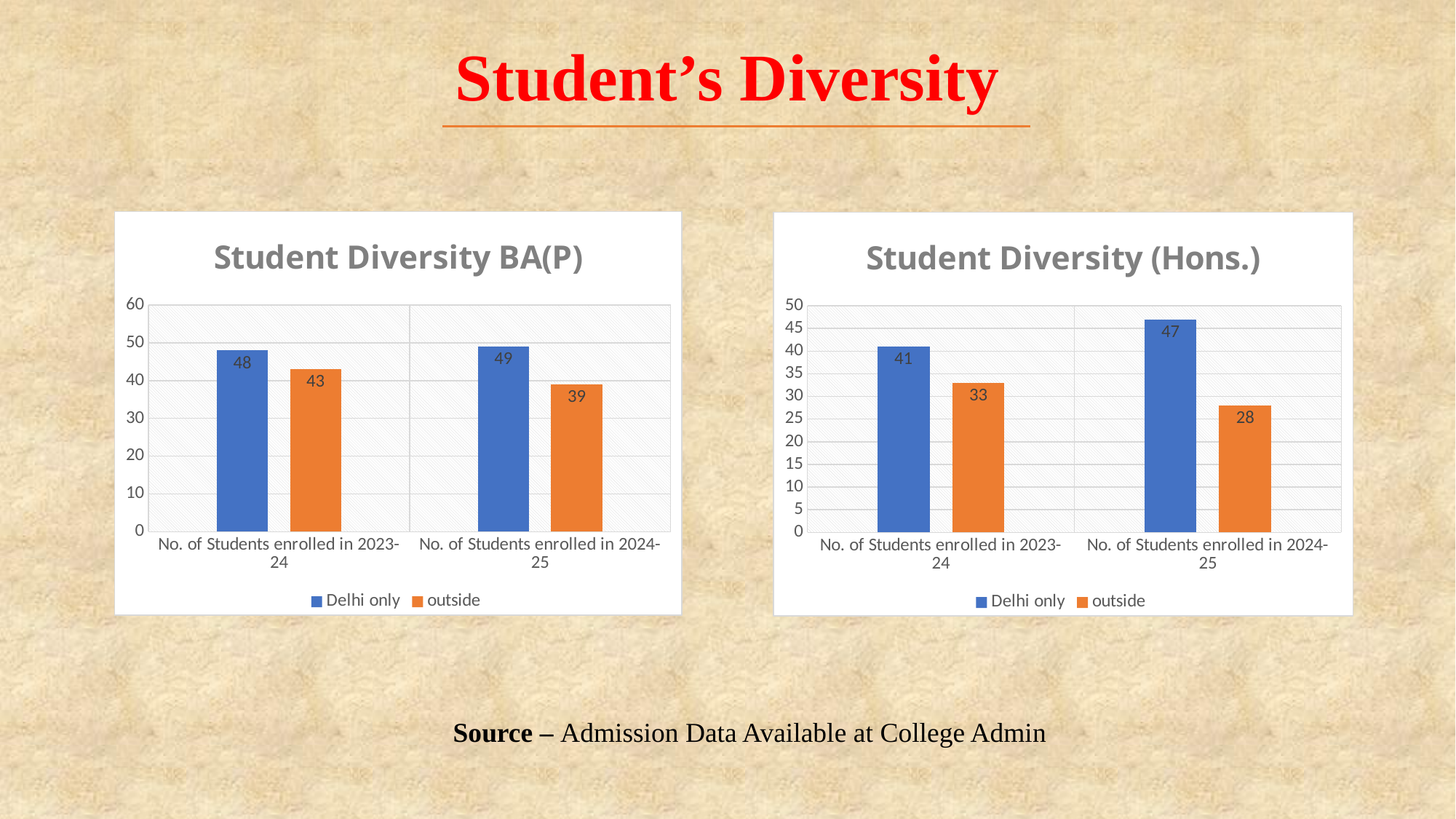
In the 'Student Diversity BA(P)' chart, which bar has the highest value? Delhi only, No. of Students enrolled in 2024-25 In the 'Student Diversity BA(P)' chart, what is the value for 'outside' for No. of Students enrolled in 2024-25? 39 How many series does the legend list in the 'Student Diversity BA(P)' chart? 2 In the 'Student Diversity (Hons.)' chart, what is the difference between 'Delhi only' and 'outside' for No. of Students enrolled in 2023-24? 8 In the 'Student Diversity (Hons.)' chart, which bar has the lowest value? outside, No. of Students enrolled in 2024-25 In the 'Student Diversity BA(P)' chart, what is the value for 'Delhi only' for No. of Students enrolled in 2023-24? 48 In the 'Student Diversity (Hons.)' chart, what is the value for 'Delhi only' for No. of Students enrolled in 2024-25? 47 What kind of chart is the 'Student Diversity (Hons.)' chart? Bar chart In the 'Student Diversity BA(P)' chart, what is the difference between 'Delhi only' and 'outside' for No. of Students enrolled in 2024-25? 10 In the 'Student Diversity (Hons.)' chart, does the 'outside' series rise or fall from 2023-24 to 2024-25? Fall In the 'Student Diversity (Hons.)' chart, which is larger: 'outside' in 2023-24 or 'outside' in 2024-25? outside in 2023-24 In the 'Student Diversity (Hons.)' chart, what is the value for 'outside' for No. of Students enrolled in 2023-24? 33